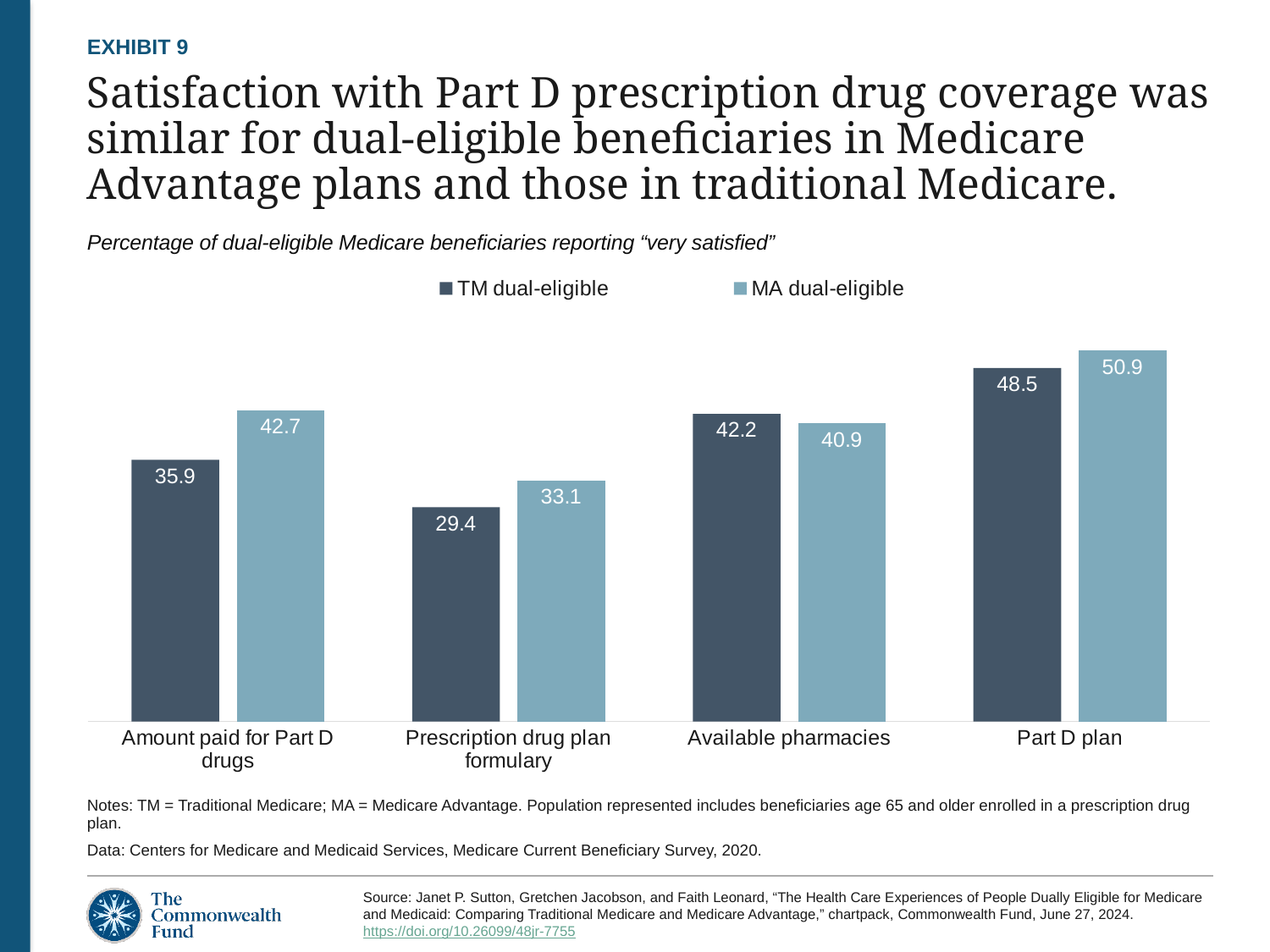
For Available pharmacies, which is larger: TM dual-eligible or MA dual-eligible? TM dual-eligible What is the value for TM dual-eligible for Amount paid for Part D drugs? 35.9 How many series does the legend list? 2 What kind of chart is shown on the slide? Bar chart What are the two series listed in the legend? TM dual-eligible and MA dual-eligible Which category has the highest value for TM dual-eligible? Part D plan What is the difference between the TM dual-eligible values for Part D plan and Prescription drug plan formulary? 19.1 What is the value for MA dual-eligible for Prescription drug plan formulary? 33.1 How many categories are shown on the x axis? 4 What is the value for MA dual-eligible for Part D plan? 50.9 What is the difference between the MA dual-eligible and TM dual-eligible values for Amount paid for Part D drugs? 6.8 Which category has the lowest value for MA dual-eligible? Prescription drug plan formulary